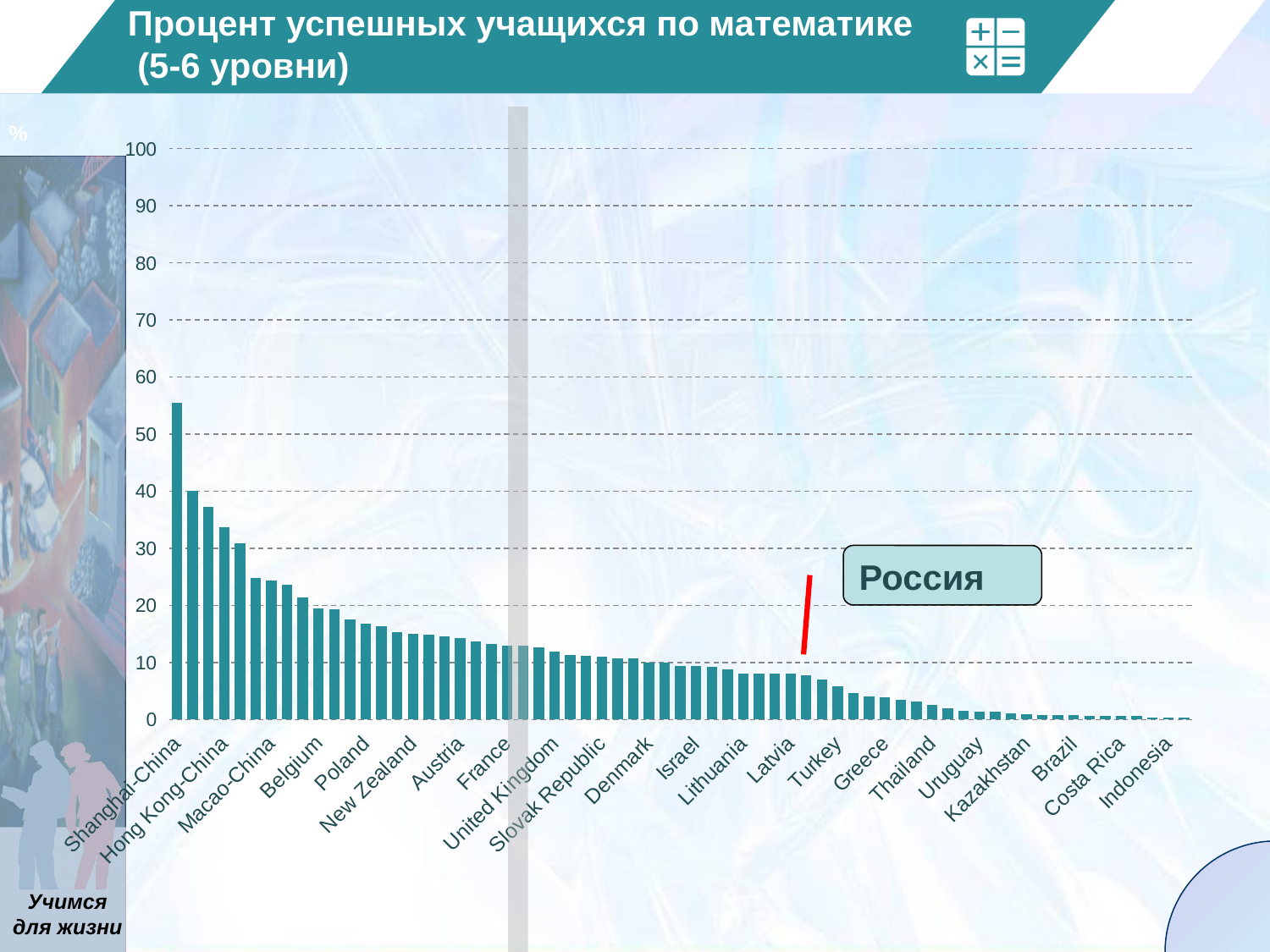
Do the values rise or fall moving from left to right along the x axis? fall Which country has the highest percentage of successful students in mathematics? Shanghai-China What kind of chart is shown on the slide? bar chart Is the value for Austria greater or less than 10? greater Which has a higher value, Shanghai-China or Hong Kong-China? Shanghai-China Is the value for Macao-China greater or less than 20? greater Is the value for Shanghai-China greater or less than 50? greater Which country is highlighted by the callout label on the chart? Россия